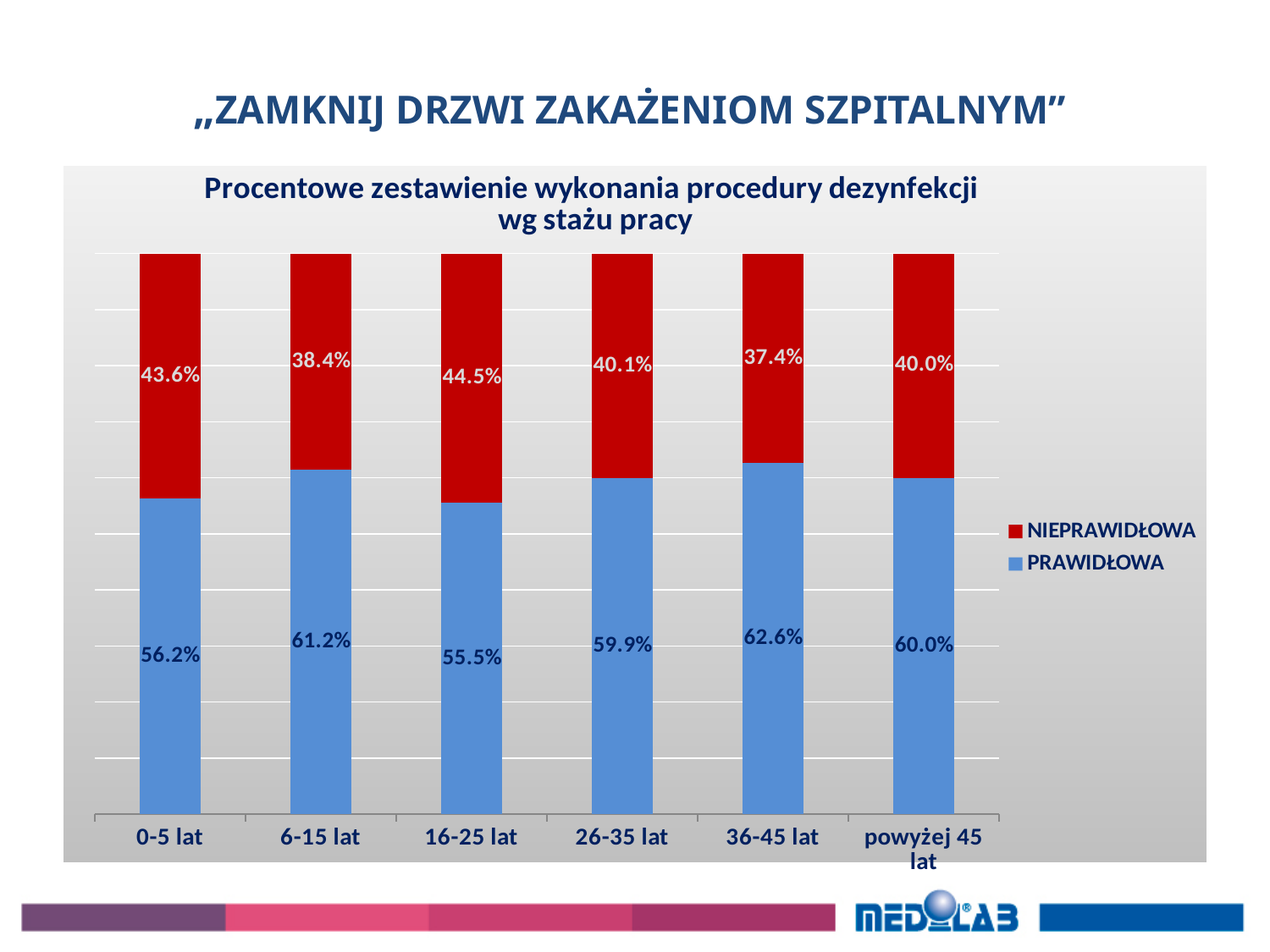
Which category has the highest NIEPRAWIDŁOWA value? 16-25 lat What is the total of the stacked bar for the 6-15 lat category? 99.6% How many series does the legend list? 2 How many age categories are shown on the x axis? 6 Which is larger: the NIEPRAWIDŁOWA value for 0-5 lat or for 26-35 lat? 0-5 lat What is the PRAWIDŁOWA value for the powyżej 45 lat category? 60.0% What is the difference between the PRAWIDŁOWA values for 36-45 lat and 0-5 lat? 6.4% Which category has the lowest PRAWIDŁOWA value? 16-25 lat What kind of chart is shown on the slide? Stacked bar chart What is the PRAWIDŁOWA value for the 6-15 lat category? 61.2% Which category has the highest PRAWIDŁOWA value? 36-45 lat What is the NIEPRAWIDŁOWA value for the 16-25 lat category? 44.5%